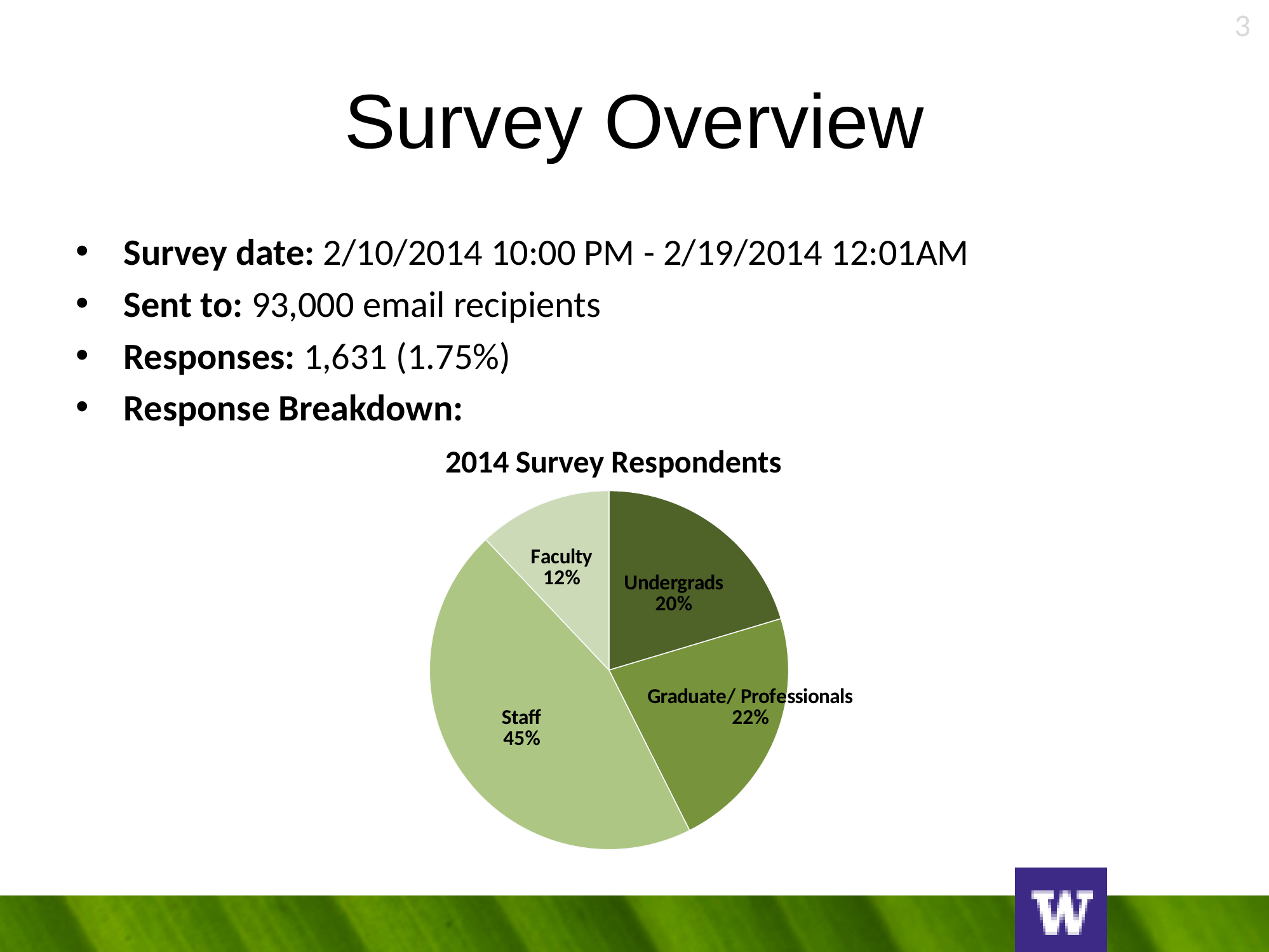
What percentage of survey respondents were Undergrads? 20% How many slices does the pie chart have? 4 What percentage of survey respondents were Faculty? 12% Which group has a larger share, Undergrads or Graduate/ Professionals? Graduate/ Professionals What percentage of survey respondents were Staff? 45% Which respondent group has the largest share of the pie? Staff What percentage of survey respondents were Graduate/ Professionals? 22% What is the difference in percentage points between the Staff and Faculty shares? 33 What kind of chart is shown on the slide? pie chart What is the combined share of Undergrads and Graduate/ Professionals? 42% What is the title of the chart? 2014 Survey Respondents Which respondent group has the smallest share of the pie? Faculty